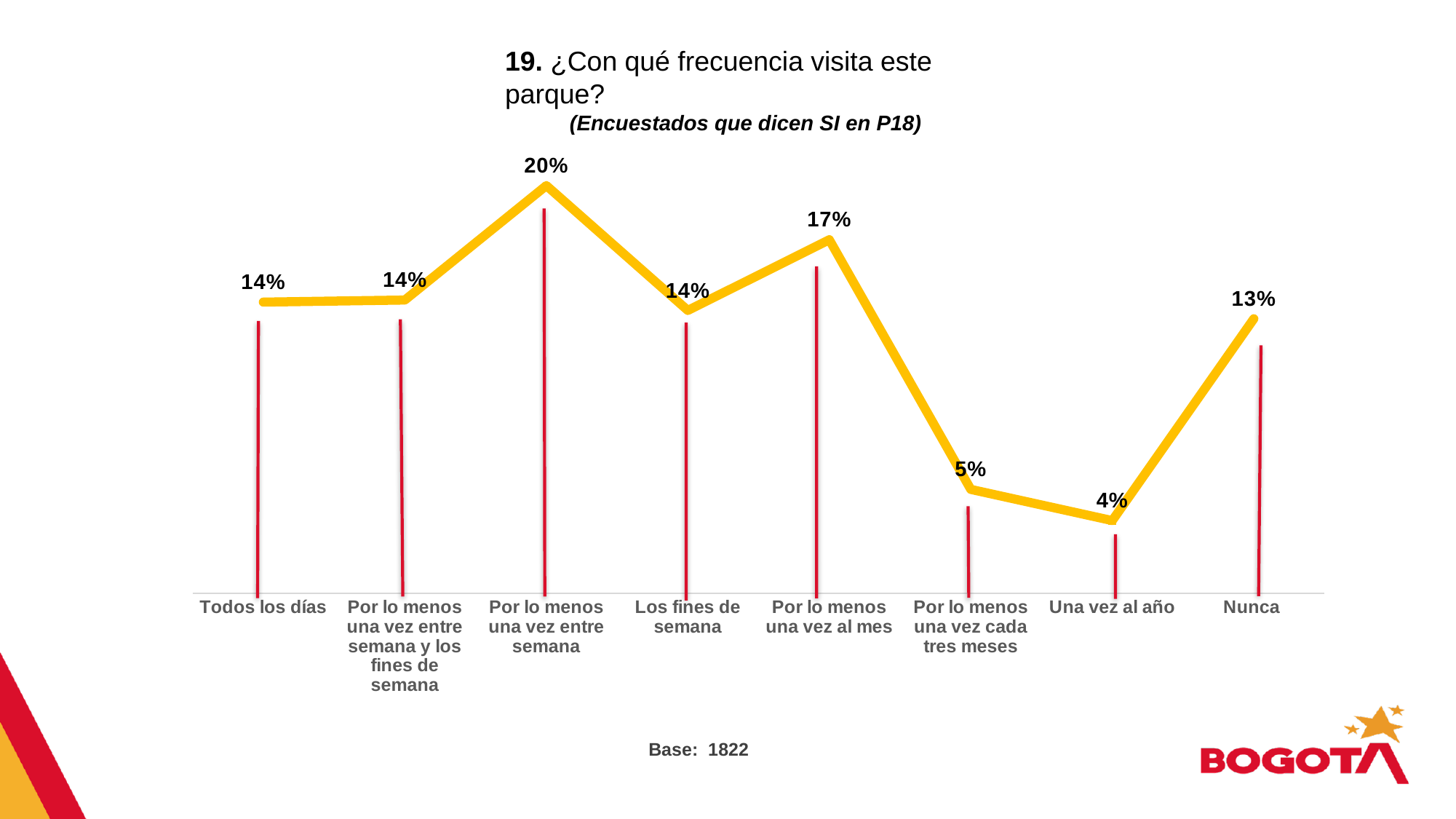
Which category has the lowest value? Una vez al año What is the base (number of respondents) shown below the chart? 1822 What is the value shown for "Una vez al año"? 4% What percentage of respondents visit the park "Por lo menos una vez entre semana"? 20% What kind of chart is shown on the slide? Line chart What is the value shown for "Nunca"? 13% How many categories are plotted on the chart? 8 Which is larger, the value for "Nunca" or the value for "Por lo menos una vez cada tres meses"? Nunca What is the difference between the values for "Por lo menos una vez entre semana" and "Por lo menos una vez al mes"? 3% What colour is the line in the chart? Yellow What is the value shown for "Por lo menos una vez al mes"? 17% Which category has the highest value? Por lo menos una vez entre semana